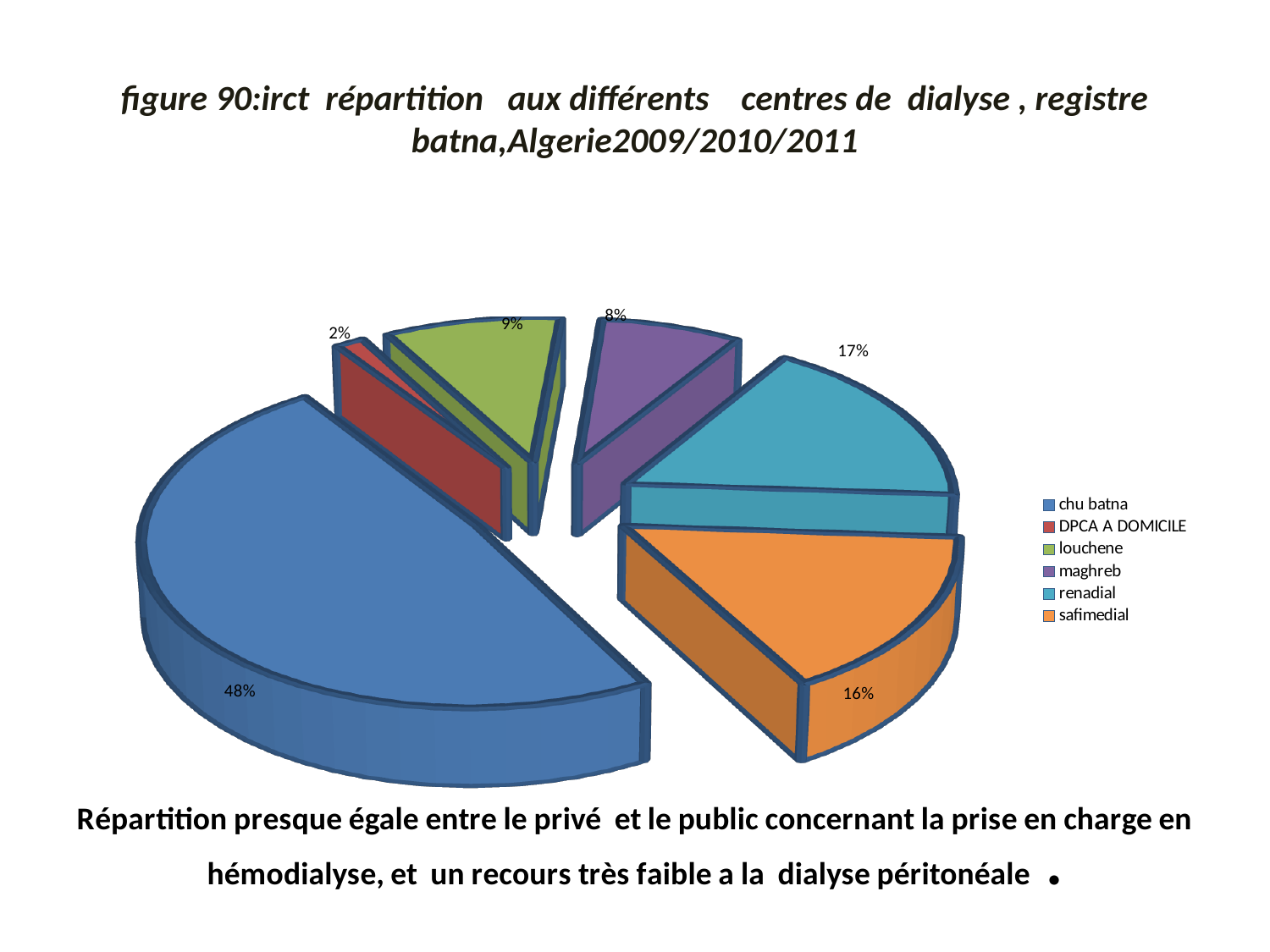
Which category has the largest slice of the pie? chu batna What percentage is shown for DPCA A DOMICILE? 2% What is the difference in percentage points between chu batna and renadial? 31 How many categories does the pie chart show? 6 Which category has the smallest slice of the pie? DPCA A DOMICILE What kind of chart is shown on the slide? pie chart What percentage is shown for louchene? 9% What colour is the slice for maghreb? purple Which is larger, the share for louchene or the share for maghreb? louchene What percentage is shown for renadial? 17% What share of the pie does chu batna account for? 48% What percentage is shown for safimedial? 16%